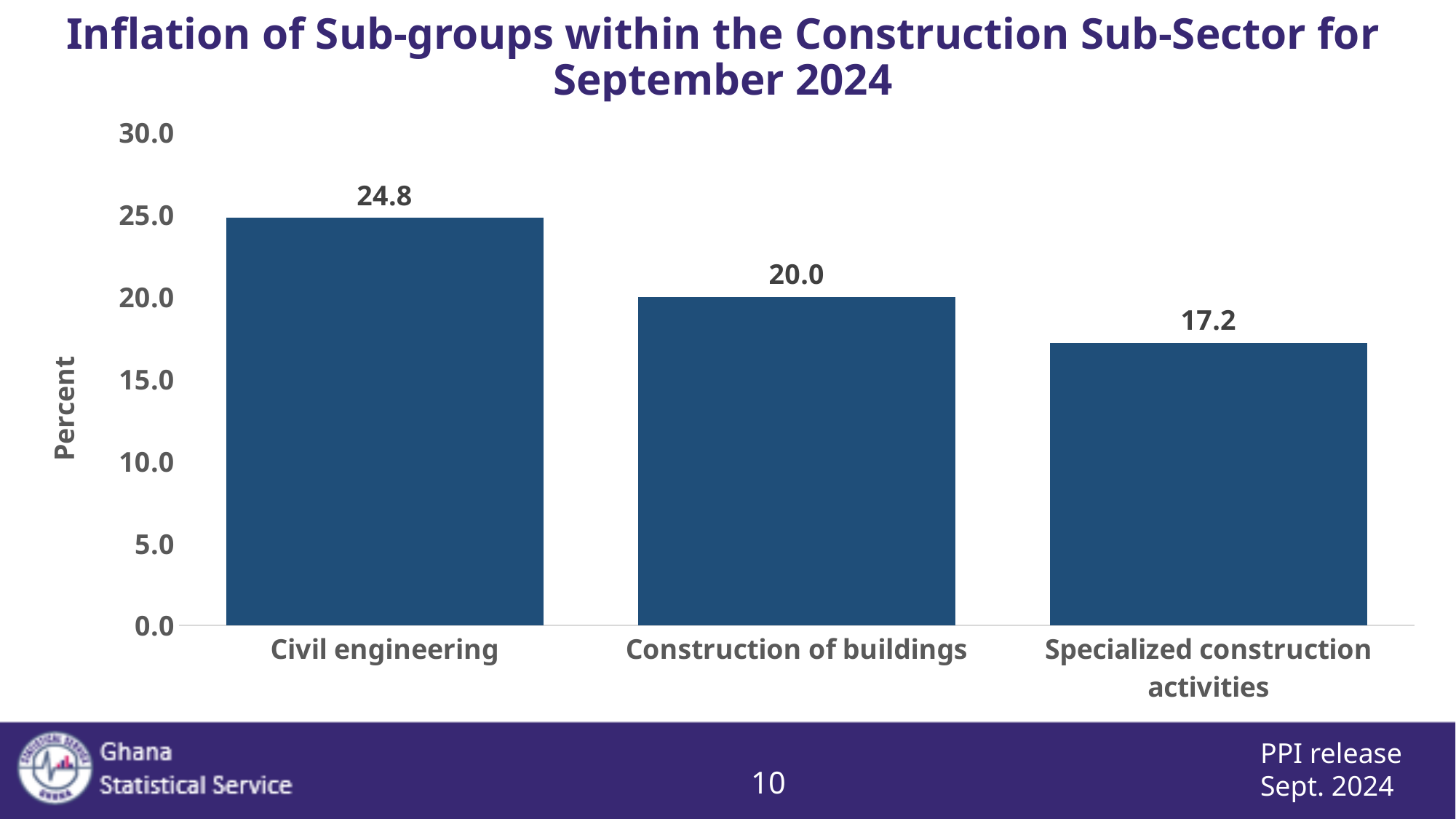
Which sub-group has the highest inflation? Civil engineering What is the inflation value for Specialized construction activities? 17.2 How many sub-groups are shown in the chart? 3 Which has higher inflation, Construction of buildings or Specialized construction activities? Construction of buildings What is the difference between the inflation for Civil engineering and Construction of buildings? 4.8 What is the label on the vertical axis of the chart? Percent What is the difference between the inflation for Construction of buildings and Specialized construction activities? 2.8 What is the inflation value for Construction of buildings? 20.0 What is the inflation value for Civil engineering? 24.8 Is the value for Specialized construction activities greater or less than 20.0? less Which sub-group has the lowest inflation? Specialized construction activities What kind of chart is shown on the slide? Bar chart